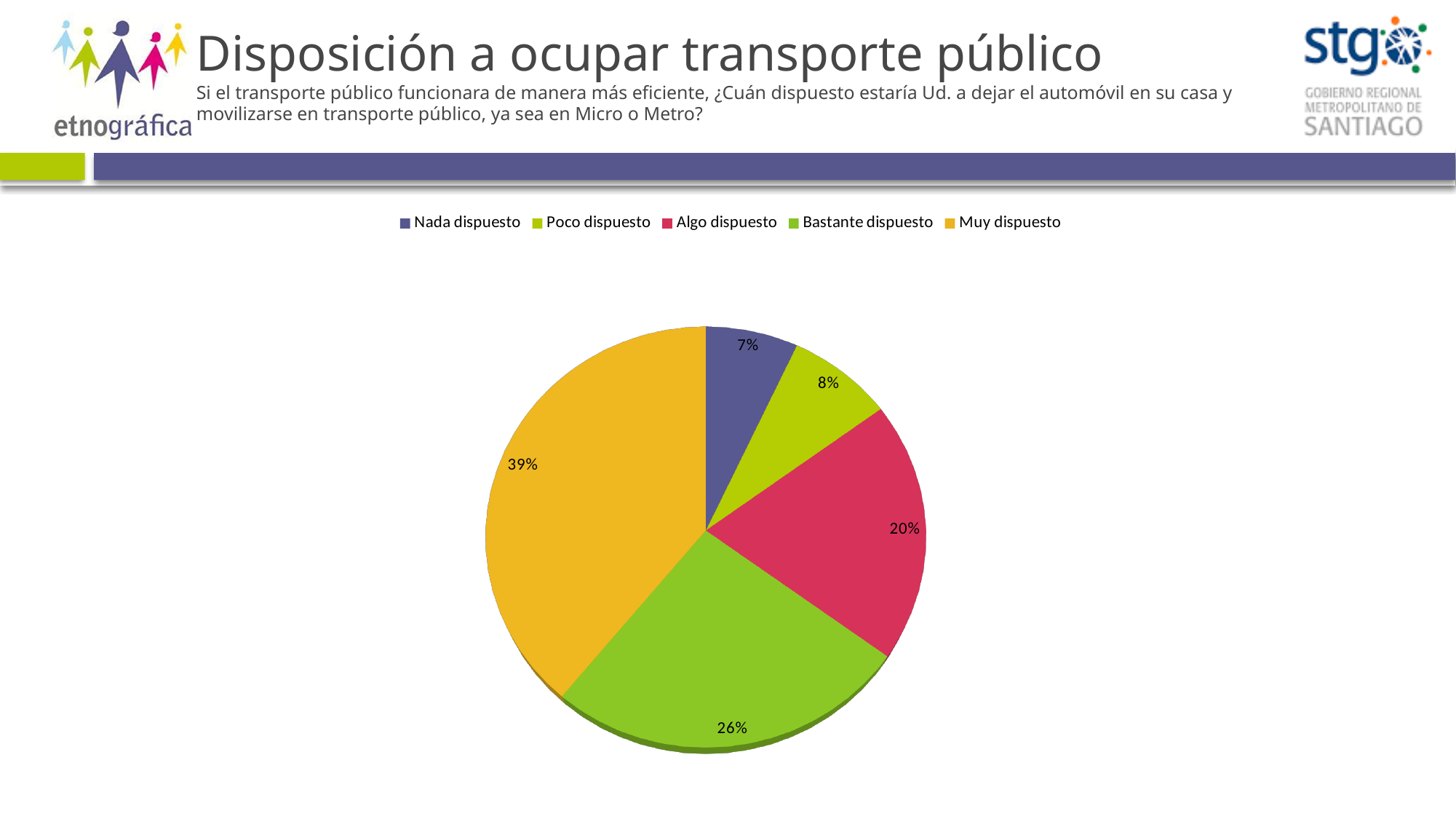
What share of the pie is labelled 'Poco dispuesto'? 8% What is the difference in percentage points between 'Muy dispuesto' and 'Bastante dispuesto'? 13 What share of the pie is labelled 'Algo dispuesto'? 20% What share of the pie is labelled 'Bastante dispuesto'? 26% What colour is the slice for 'Algo dispuesto'? red Which is larger, the slice for 'Algo dispuesto' or the slice for 'Poco dispuesto'? Algo dispuesto How many categories does the legend list? 5 Which category has the largest slice of the pie? Muy dispuesto Which category has the smallest slice of the pie? Nada dispuesto What kind of chart is shown on the slide? pie chart